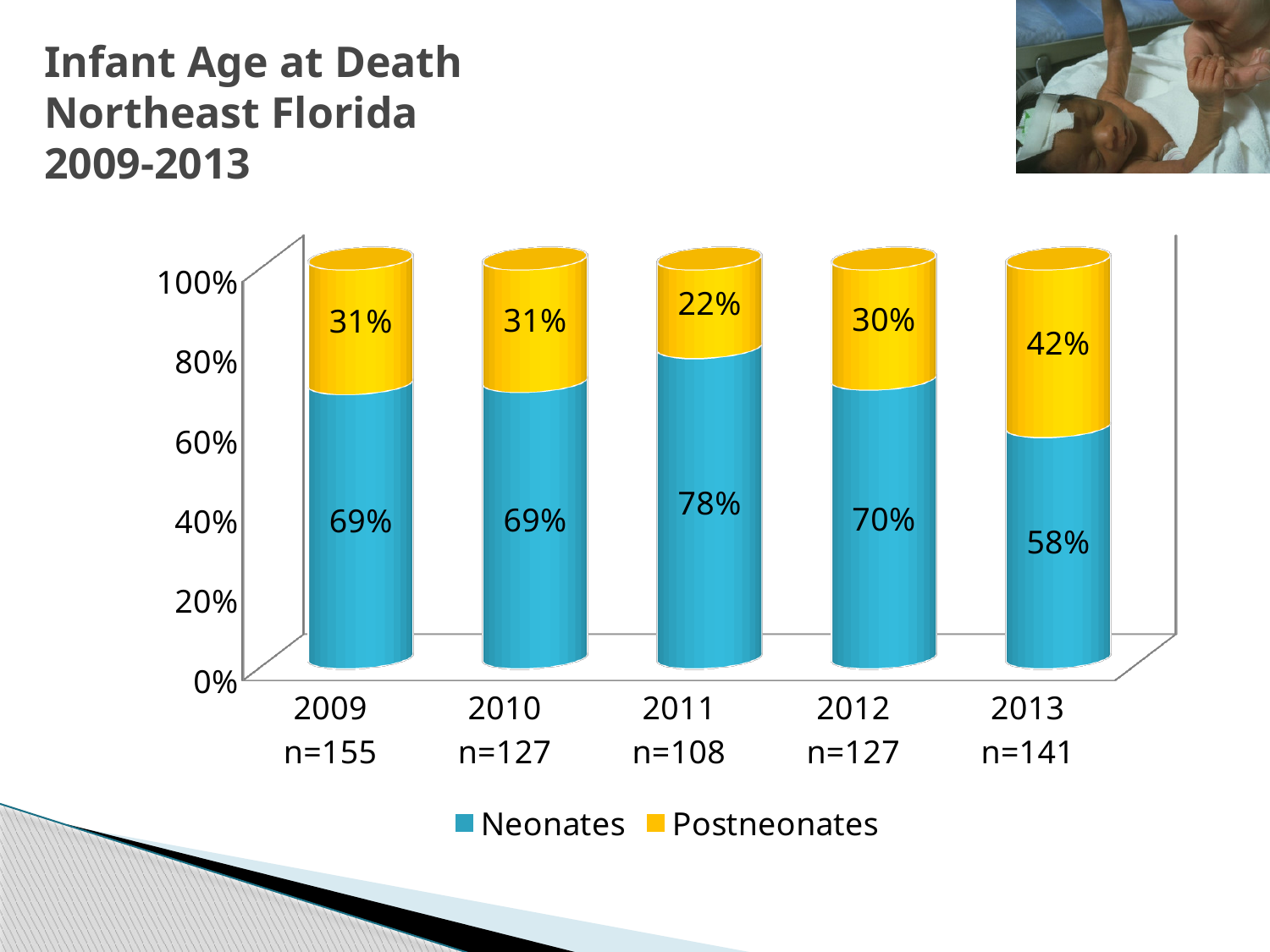
What percentage of infant deaths in 2013 were Postneonates? 42% How many years are shown on the x axis? 5 What percentage of infant deaths in 2011 were Neonates? 78% Which year has the highest Neonates percentage? 2011 Which year has the lowest Neonates percentage? 2013 Which year has the highest Postneonates percentage? 2013 What is the difference between the Neonates percentage in 2011 and in 2013? 20% Is the Postneonates percentage larger in 2012 or in 2013? 2013 What kind of chart is shown on the slide? Stacked bar chart What is the Neonates value for 2009? 69% What is the sample size (n) shown for 2011? n=108 How many series does the legend list? 2